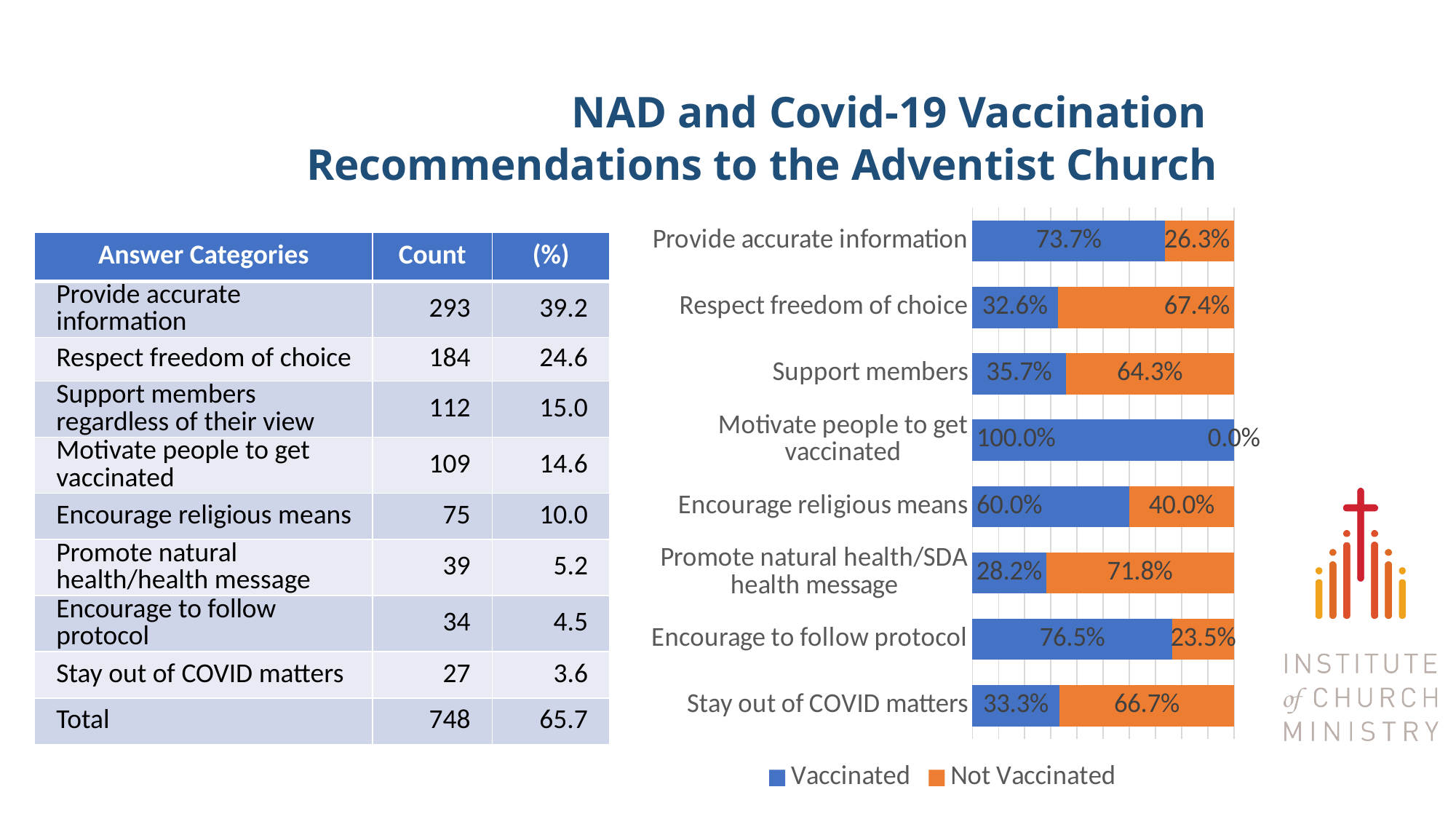
What colour represents the Vaccinated series in the chart? Blue What is the Vaccinated percentage for "Provide accurate information" in the chart? 73.7% For "Support members" in the chart, which is larger: the Vaccinated or the Not Vaccinated percentage? Not Vaccinated In the chart, what is the difference between the Vaccinated and Not Vaccinated percentages for "Encourage religious means"? 20.0 percentage points What kind of chart is shown on the slide? Stacked bar chart How many categories are shown in the chart? 8 What is the Not Vaccinated percentage for "Respect freedom of choice" in the chart? 67.4% Which category in the chart has the highest Not Vaccinated percentage? Promote natural health/SDA health message How many series does the chart's legend list? 2 Which category in the chart has the lowest Vaccinated percentage? Promote natural health/SDA health message What is the Not Vaccinated percentage for "Encourage to follow protocol" in the chart? 23.5% Which category in the chart has the highest Vaccinated percentage? Motivate people to get vaccinated